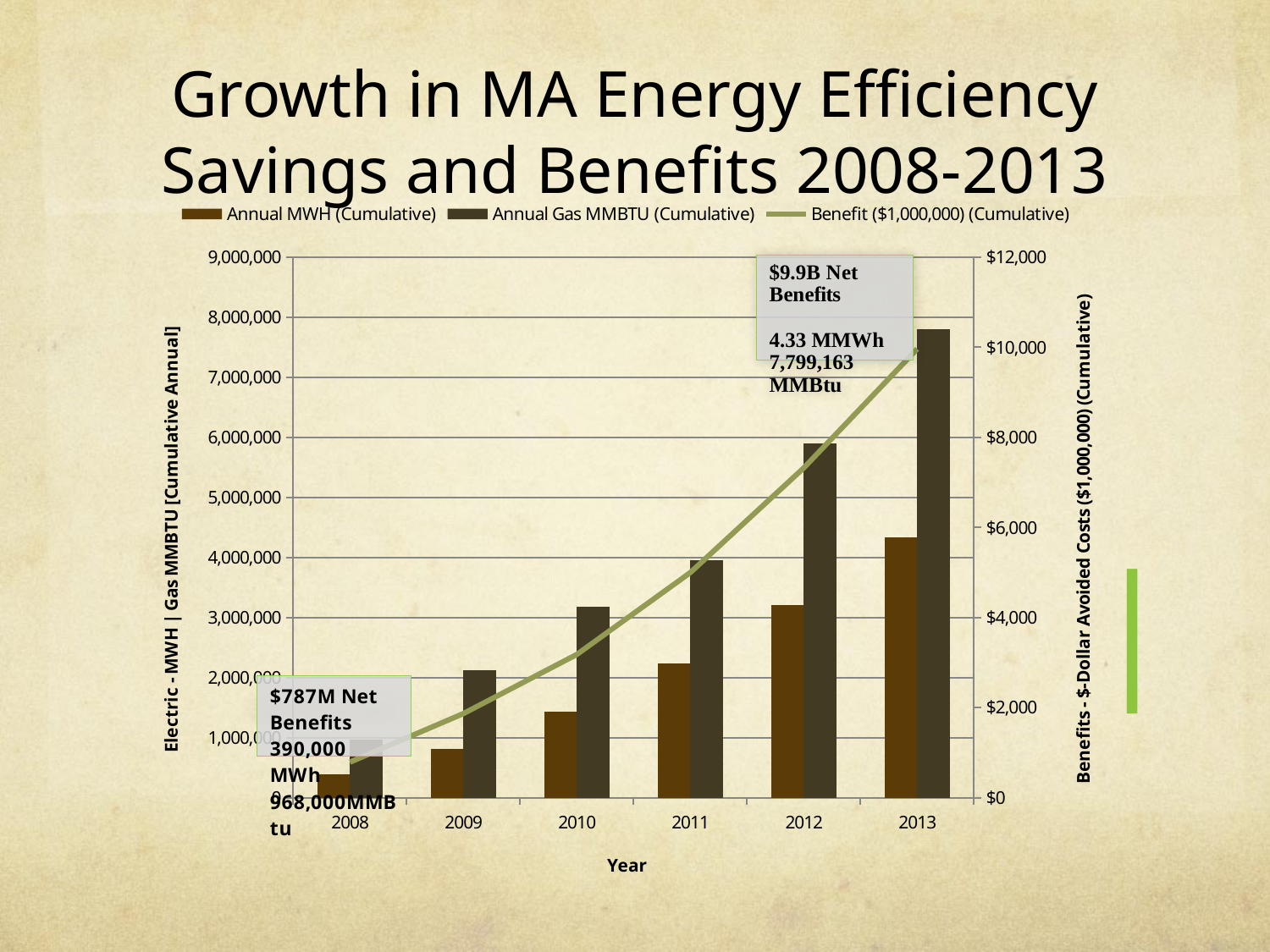
How many years are shown on the x axis? 6 What is the title of the x axis? Year How many series does the legend list? 3 What kind of chart is shown on the slide? A combination bar and line chart Which year has the highest Annual Gas MMBTU (Cumulative) bar? 2013 In 2012, which is larger: the Annual MWH (Cumulative) bar or the Annual Gas MMBTU (Cumulative) bar? Annual Gas MMBTU (Cumulative) Is the Annual MWH (Cumulative) value for 2011 greater or less than 3,000,000? less According to the annotation, what is the cumulative gas savings in MMBtu for 2013? 7,799,163 MMBtu Do the Benefit ($1,000,000) (Cumulative) values rise or fall from 2008 to 2013? Rise Is the Annual Gas MMBTU (Cumulative) value for 2012 greater or less than 5,000,000? greater Which year has the lowest Annual MWH (Cumulative) bar? 2008 According to the annotation, what are the net benefits for 2008? $787M